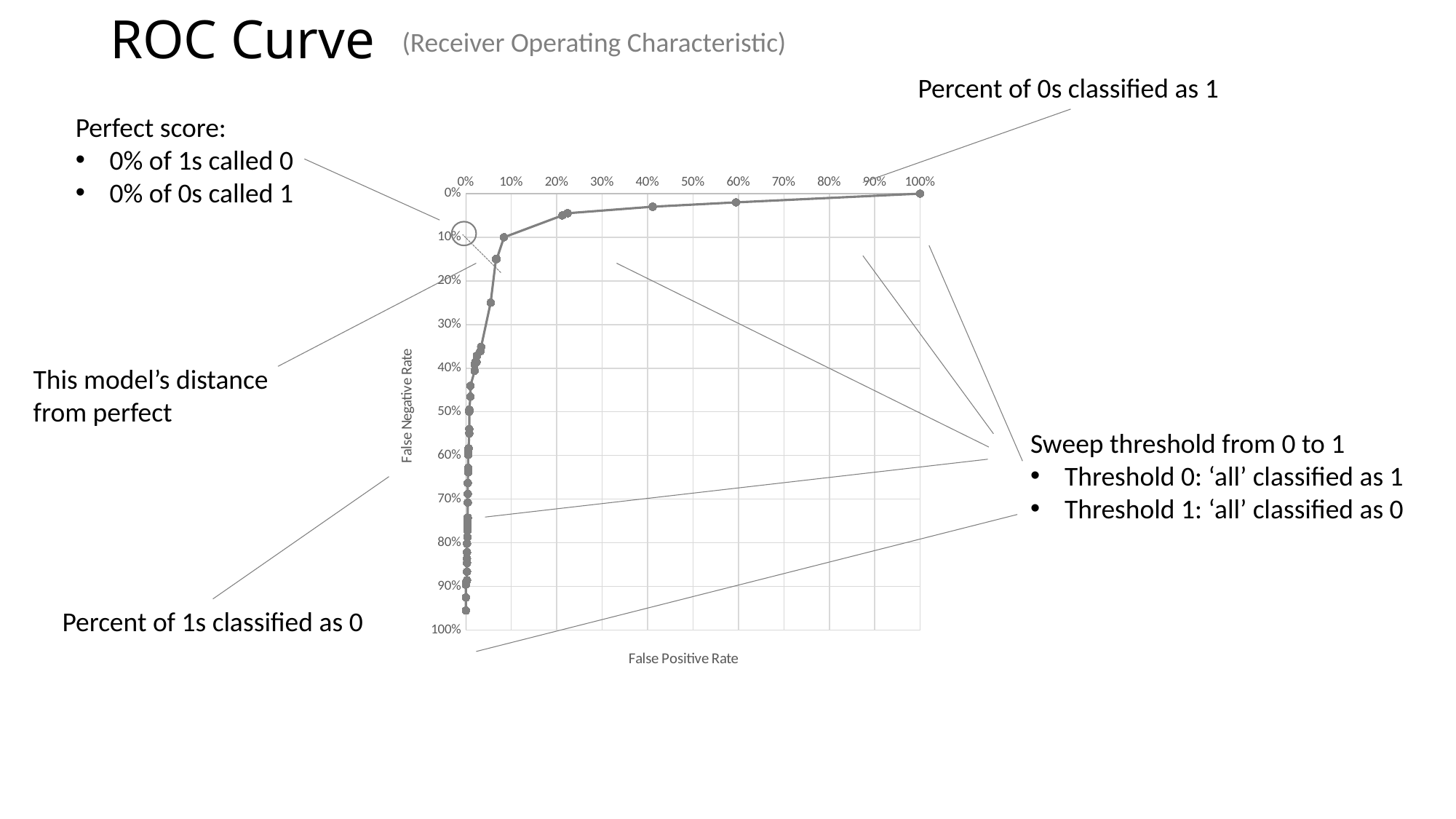
Is the highest false negative rate plotted on the curve greater or less than 90%? greater As the false positive rate increases along the x axis, does the false negative rate rise or fall? fall Is the false negative rate at a false positive rate of 40% greater or less than 10%? less What is the false positive rate of the rightmost point on the curve? 100% Is the false negative rate at a false positive rate of 60% greater or less than 10%? less What is the title of the y axis of the chart? False Negative Rate What is the false negative rate at the point where the false positive rate is 100%? 0% Which point on the curve has the lowest false negative rate? the point at 100% false positive rate What kind of chart is shown on the slide? line chart What is the title of the x axis of the chart? False Positive Rate